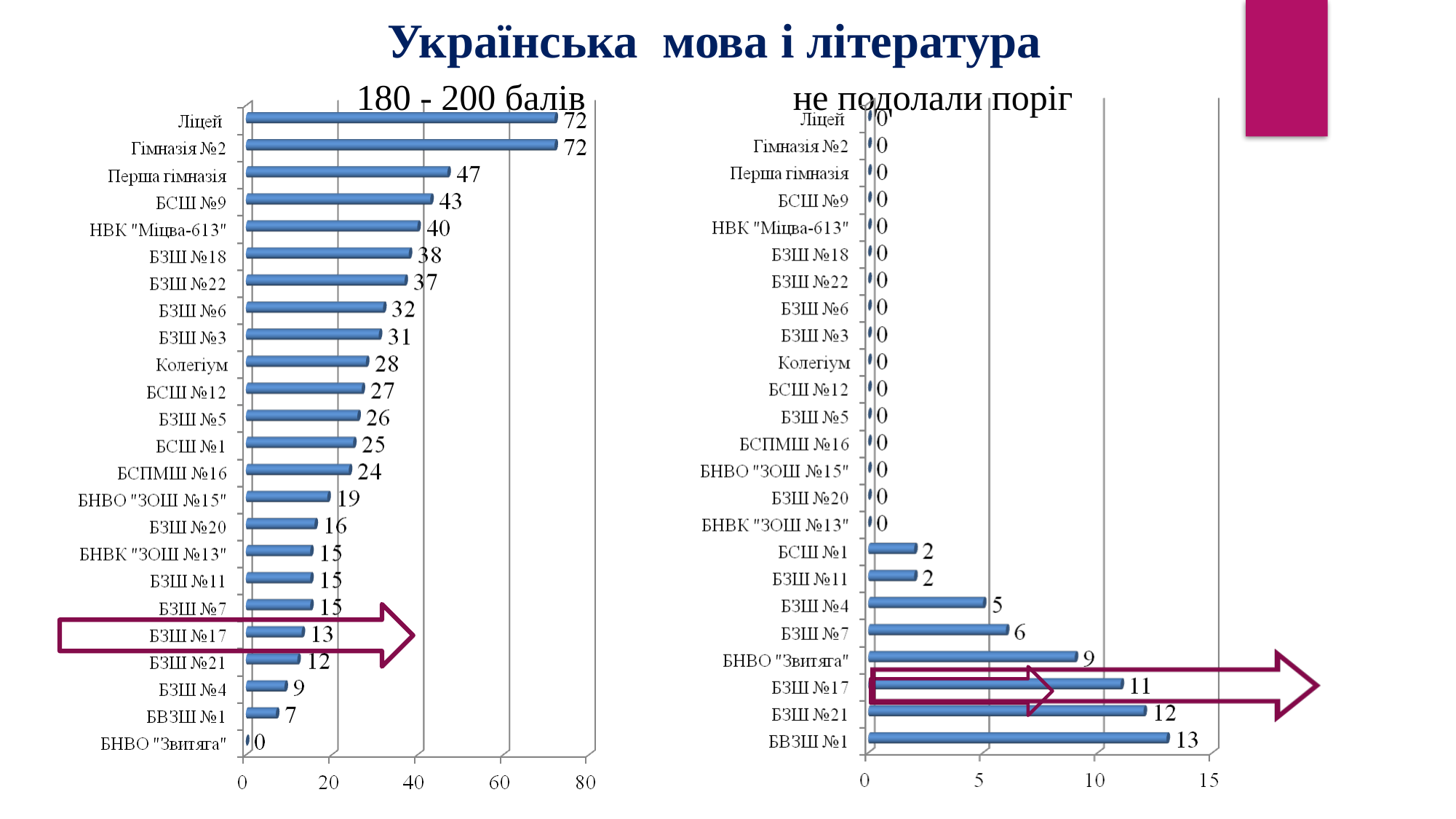
What kind of chart is the chart titled "не подолали поріг"? bar chart In the chart titled "180 - 200 балів", which category has the lowest value? БНВО "Звитяга" In the chart titled "180 - 200 балів", what is the difference between the values for БСШ №9 and БЗШ №18? 5 In the chart titled "180 - 200 балів", what is the value for БЗШ №17? 13 In the chart titled "180 - 200 балів", what is the value for Перша гімназія? 47 In the chart titled "180 - 200 балів", which is larger, the value for Колегіум or the value for БЗШ №20? Колегіум In the chart titled "не подолали поріг", what is the value for БЗШ №17? 11 What is the title of the chart on the left side of the slide? 180 - 200 балів In the chart titled "не подолали поріг", which category has the highest value? БВЗШ №1 In the chart titled "180 - 200 балів", how many categories are shown? 24 In the chart titled "не подолали поріг", what is the difference between the values for БЗШ №21 and БЗШ №7? 6 In the chart titled "не подолали поріг", what is the value for БНВО "Звитяга"? 9